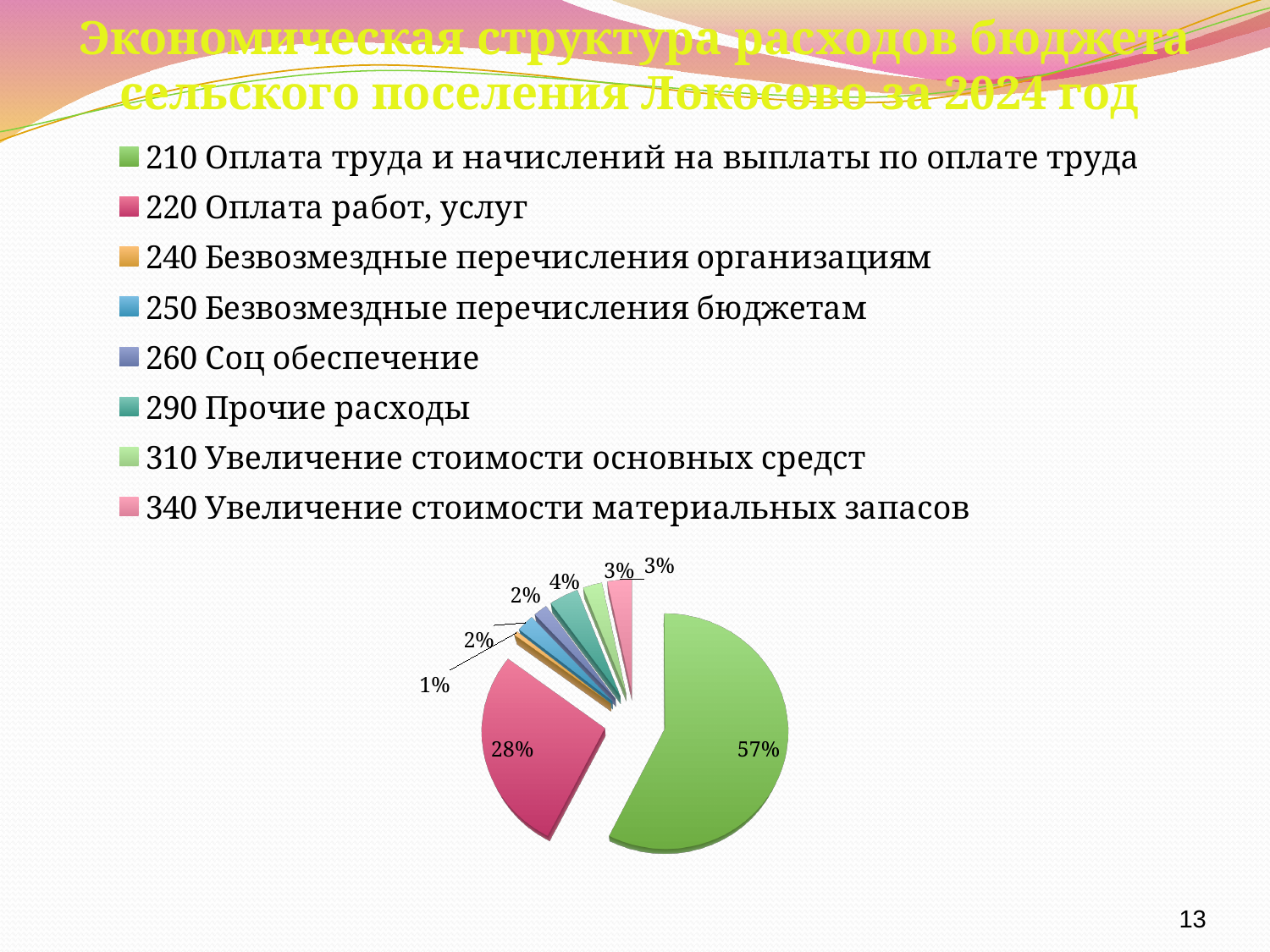
Which category has the largest slice of the pie? 210 Оплата труда и начислений на выплаты по оплате труда Which is larger: the share of "220 Оплата работ, услуг" or the share of "290 Прочие расходы"? 220 Оплата работ, услуг What share of the pie does "210 Оплата труда и начислений на выплаты по оплате труда" have? 57% What type of chart is shown on the slide? Pie chart By how many percentage points does the share of "210 Оплата труда и начислений на выплаты по оплате труда" exceed that of "220 Оплата работ, услуг"? 29 percentage points What colour is the legend marker for "220 Оплата работ, услуг"? Pink (magenta) How many categories are shown in the pie chart? 8 What share of the pie does "290 Прочие расходы" have? 4% Which category has the smallest slice of the pie? 240 Безвозмездные перечисления организациям What is the combined share of "310 Увеличение стоимости основных средст" and "340 Увеличение стоимости материальных запасов"? 6% What share of the pie does "240 Безвозмездные перечисления организациям" have? 1% What share of the pie does "220 Оплата работ, услуг" have? 28%